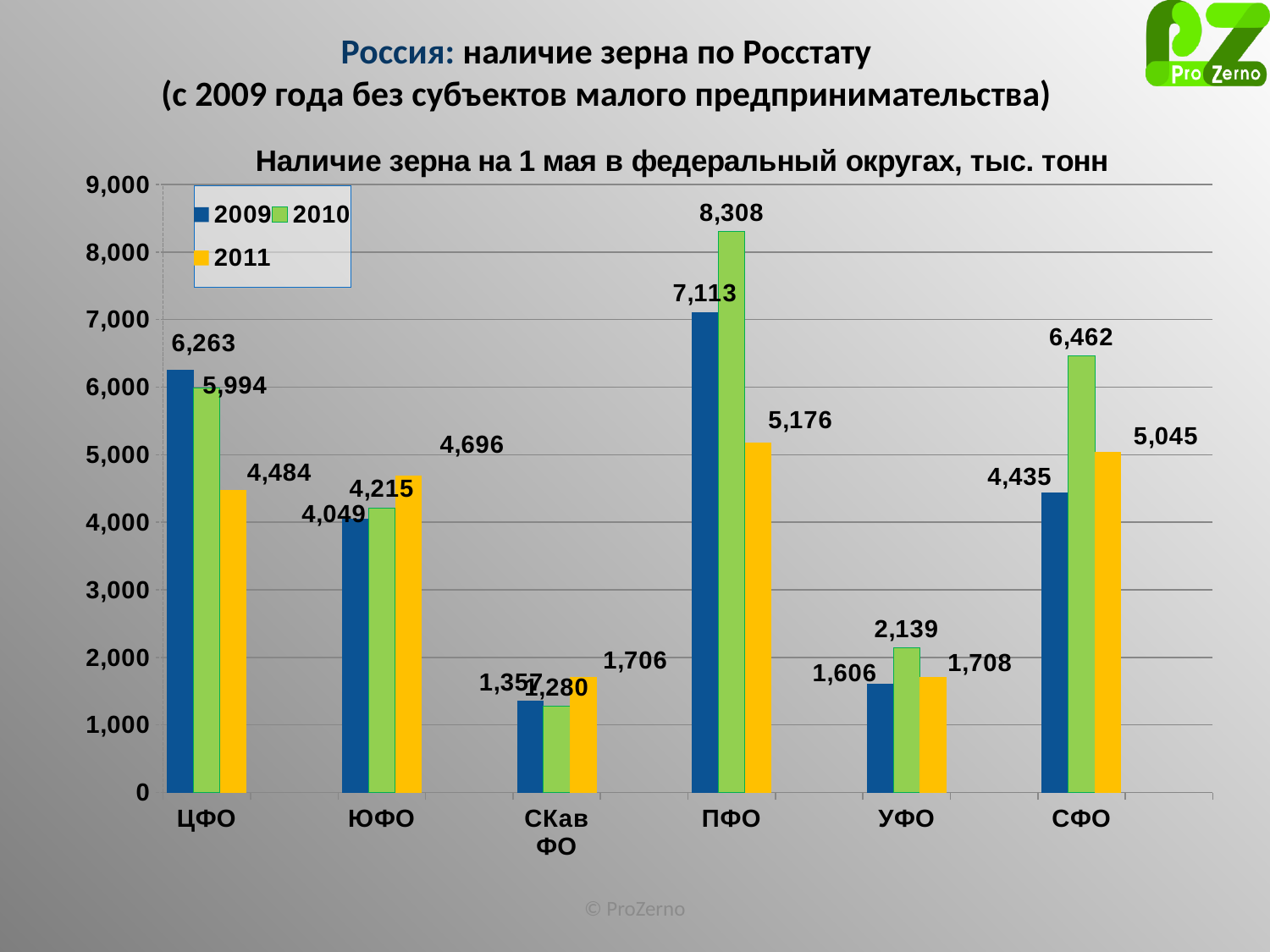
What is the title of the chart? Наличие зерна на 1 мая в федеральный округах, тыс. тонн Which is larger in the 2011 series: ЦФО or ЮФО? ЮФО How many federal districts are shown on the x axis? 6 How many series does the legend list? 3 Which federal district has the lowest value in the 2009 series? СКав ФО Is the 2011 value for ПФО greater or less than 5,000? greater What kind of chart is shown on the slide? bar chart What is the value for ПФО in the 2010 series? 8,308 What is the difference between the 2010 and 2009 values for ПФО? 1,195 Which federal district has the highest value in the 2010 series? ПФО What is the value for СФО in the 2011 series? 5,045 What is the value for ЦФО in the 2009 series? 6,263